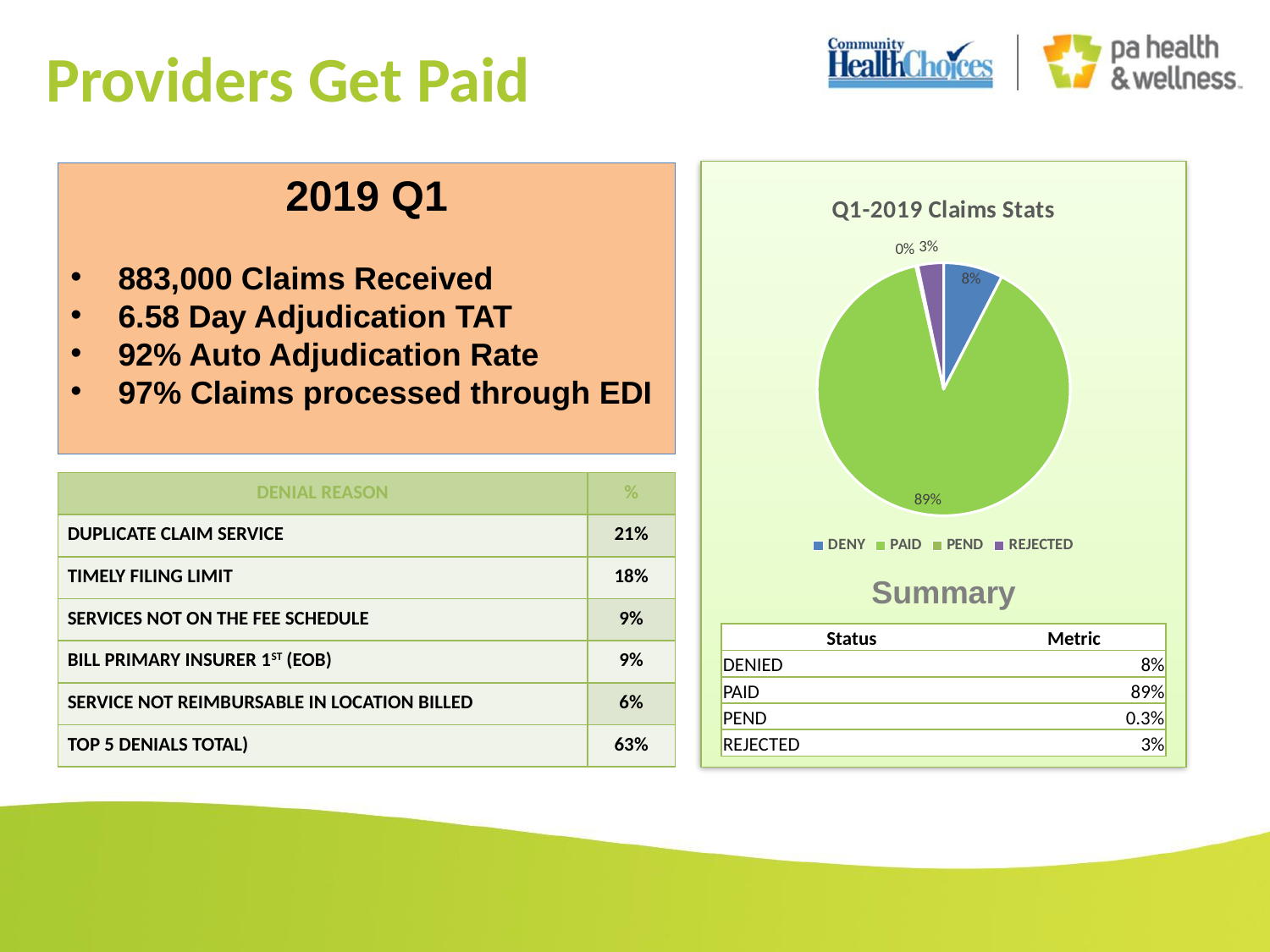
What is the title of the chart? Q1-2019 Claims Stats How many categories does the legend of the Q1-2019 Claims Stats chart list? 4 What kind of chart is shown on the slide? pie chart Which category has the smallest slice in the Q1-2019 Claims Stats chart? PEND What percentage does the PAID slice show in the Q1-2019 Claims Stats chart? 89% What percentage does the DENY slice show in the Q1-2019 Claims Stats chart? 8% What is the difference between the DENY and REJECTED percentages in the Q1-2019 Claims Stats chart? 5% Which slice is larger in the Q1-2019 Claims Stats chart, DENY or REJECTED? DENY What percentage does the REJECTED slice show in the Q1-2019 Claims Stats chart? 3% What is the difference between the PAID and DENY percentages in the Q1-2019 Claims Stats chart? 81% Which category has the largest slice in the Q1-2019 Claims Stats chart? PAID What colour is the PAID slice in the Q1-2019 Claims Stats chart? green